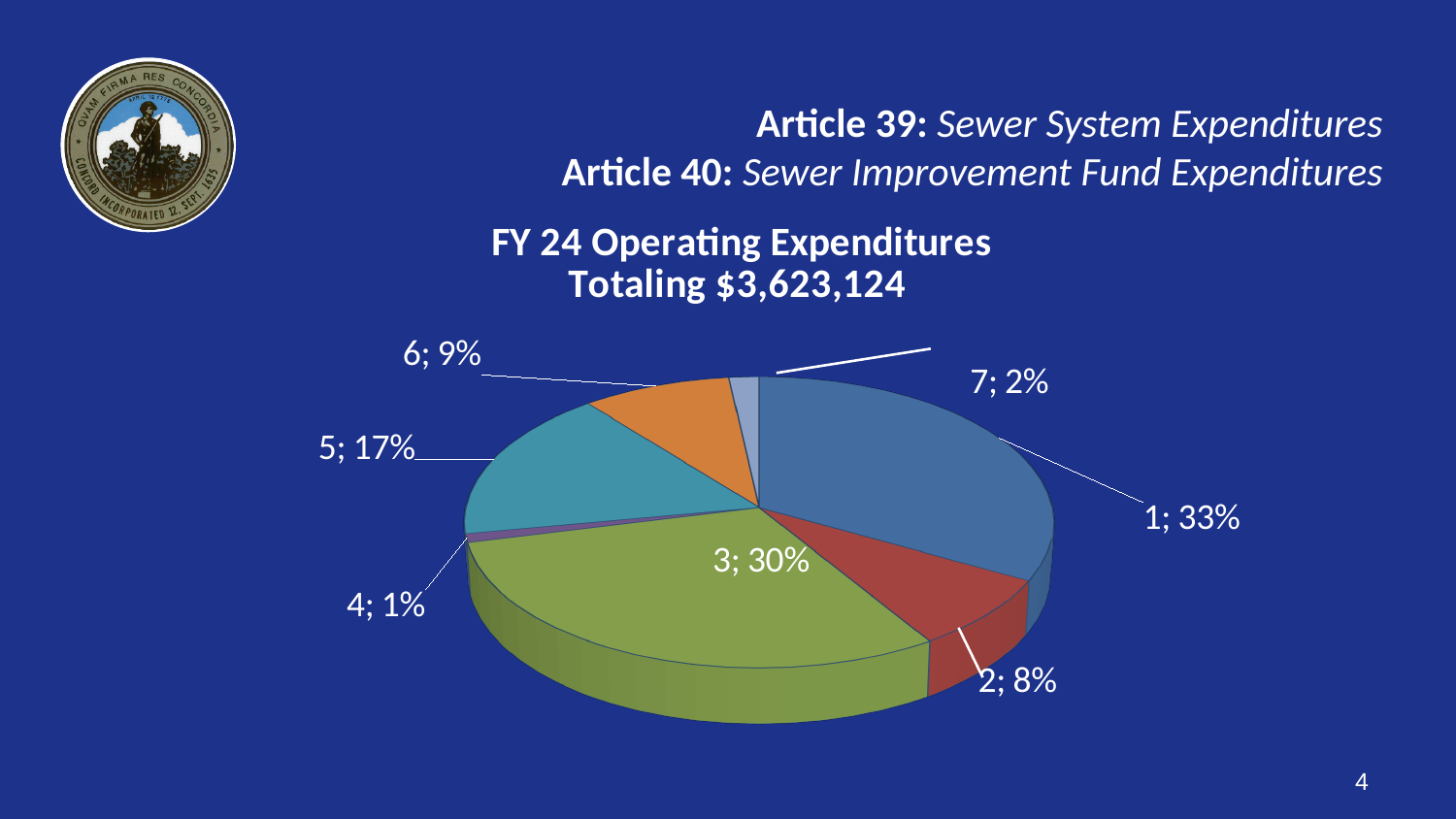
What kind of chart is shown on the slide? pie chart Which category has the largest share of the pie? 1 What share of the pie does category 5 represent? 17% What percentage is shown for category 2? 8% What is the difference in percentage points between category 5 and category 6? 8 Which has a larger share, category 2 or category 7? 2 How many slices does the pie chart have? 7 What total amount is stated in the chart title? $3,623,124 Which category has the smallest share of the pie? 4 What share of the pie does category 1 represent? 33% What share of the pie does category 3 represent? 30% What percentage is shown for category 6? 9%